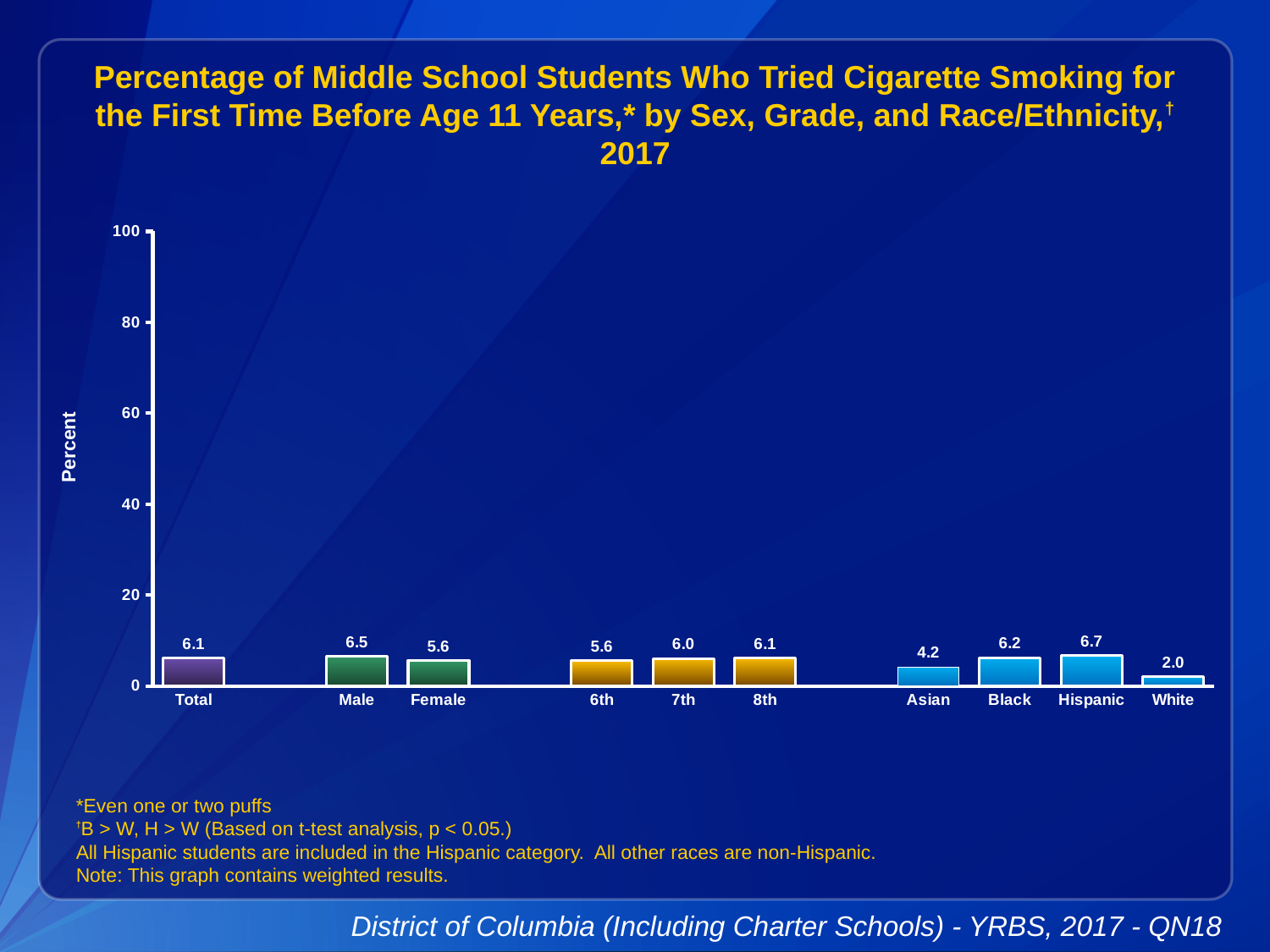
Which category has the lowest value? White How many categories are shown on the x axis? 10 What is the difference between the values for Male and Female? 0.9 Which is larger, the value for Asian or the value for Black? Black What is the label of the y axis? Percent Is the value for 8th grade greater or less than 20? less Do the values rise or fall from 6th grade to 8th grade? rise What is the value for 6th grade? 5.6 Which category has the highest value? Hispanic What is the value for Total? 6.1 What kind of chart is this? bar chart What is the value for Hispanic students? 6.7